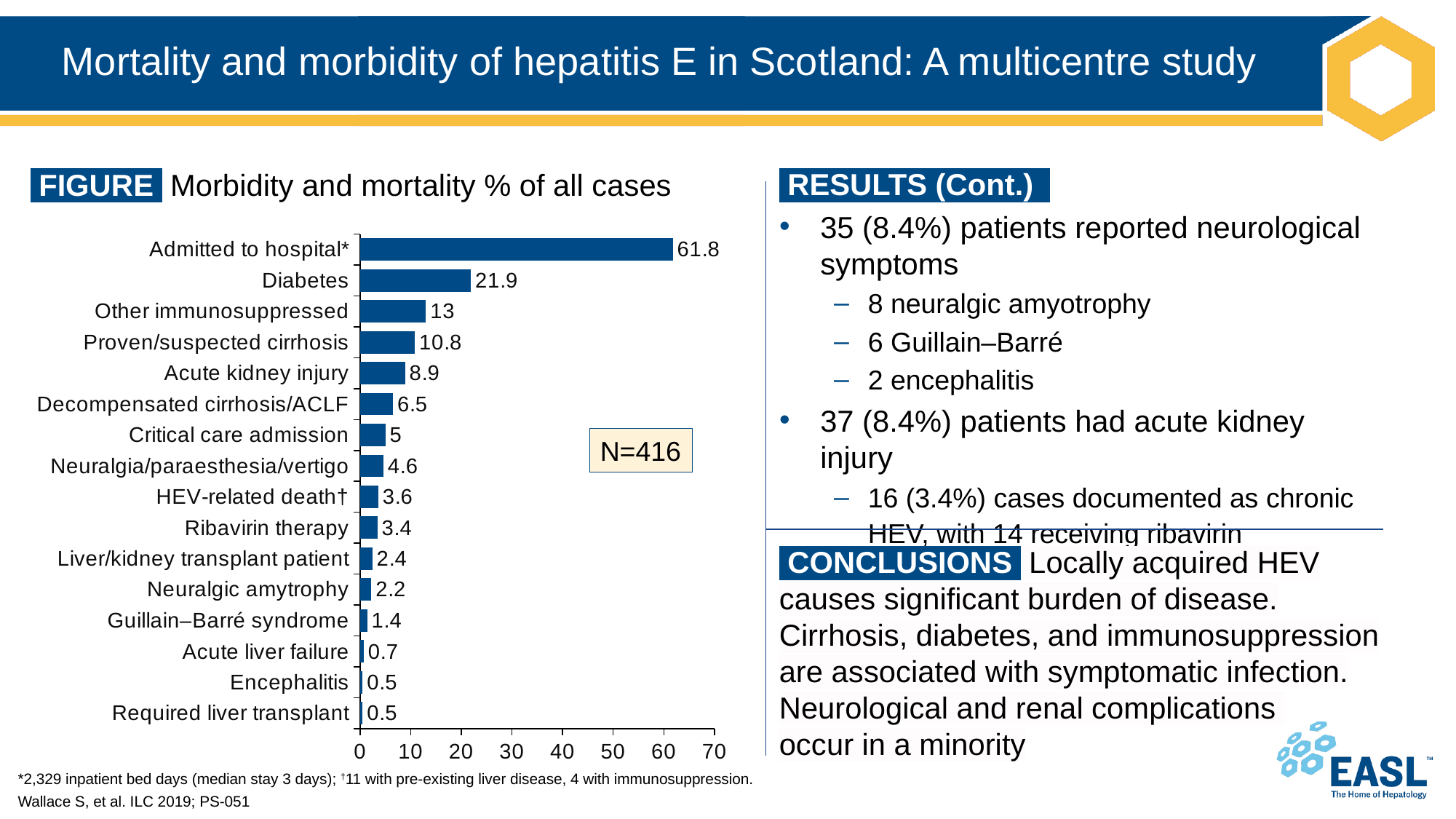
What is the value for Admitted to hospital*? 61.8 What kind of chart is shown on the slide? bar chart What is the difference between the values for Diabetes and Other immunosuppressed? 8.9 What is the value for Ribavirin therapy? 3.4 Is the value for Admitted to hospital* greater or less than 60? greater Which category has the highest value? Admitted to hospital* How many categories are shown in the chart? 16 What sample size is shown in the box on the chart? N=416 Which is larger, the value for Proven/suspected cirrhosis or the value for Acute kidney injury? Proven/suspected cirrhosis What is the value for HEV-related death†? 3.6 What is the value for Acute kidney injury? 8.9 What is the value for Diabetes? 21.9